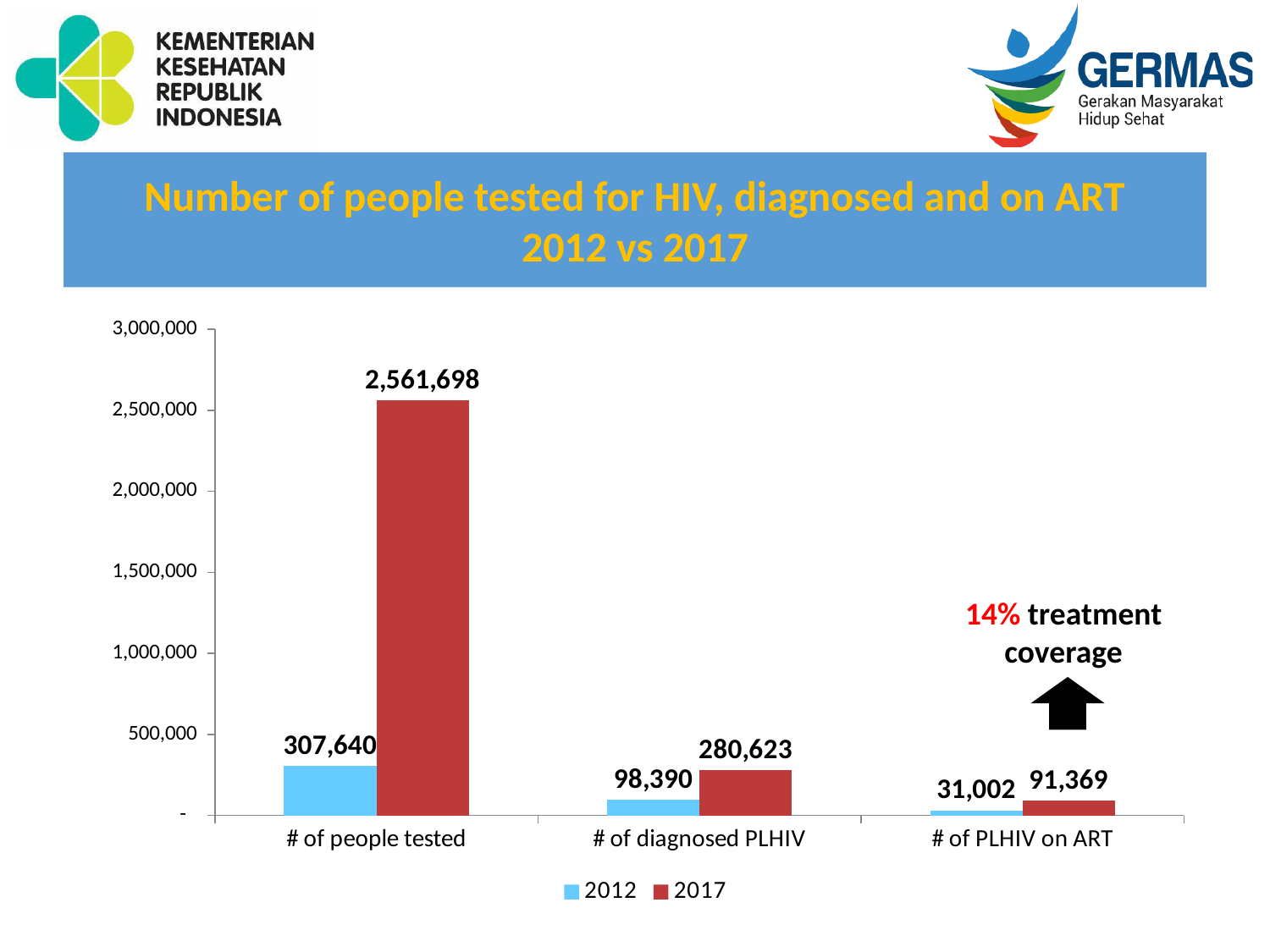
Which is larger: the 2012 value for # of diagnosed PLHIV or the 2012 value for # of people tested? # of people tested What is the number of PLHIV on ART in 2012? 31,002 Which category has the highest value for 2017? # of people tested What is the number of diagnosed PLHIV in 2017? 280,623 What kind of chart is shown on the slide? Bar chart What is the difference between the 2017 and 2012 values for # of PLHIV on ART? 60,367 What is the difference between the 2017 and 2012 values for # of people tested? 2,254,058 Is the 2017 value for # of people tested greater or less than 2,500,000? greater What is the number of people tested in 2012? 307,640 Which category has the lowest value for 2012? # of PLHIV on ART How many series does the legend list? 2 What is the number of people tested in 2017? 2,561,698